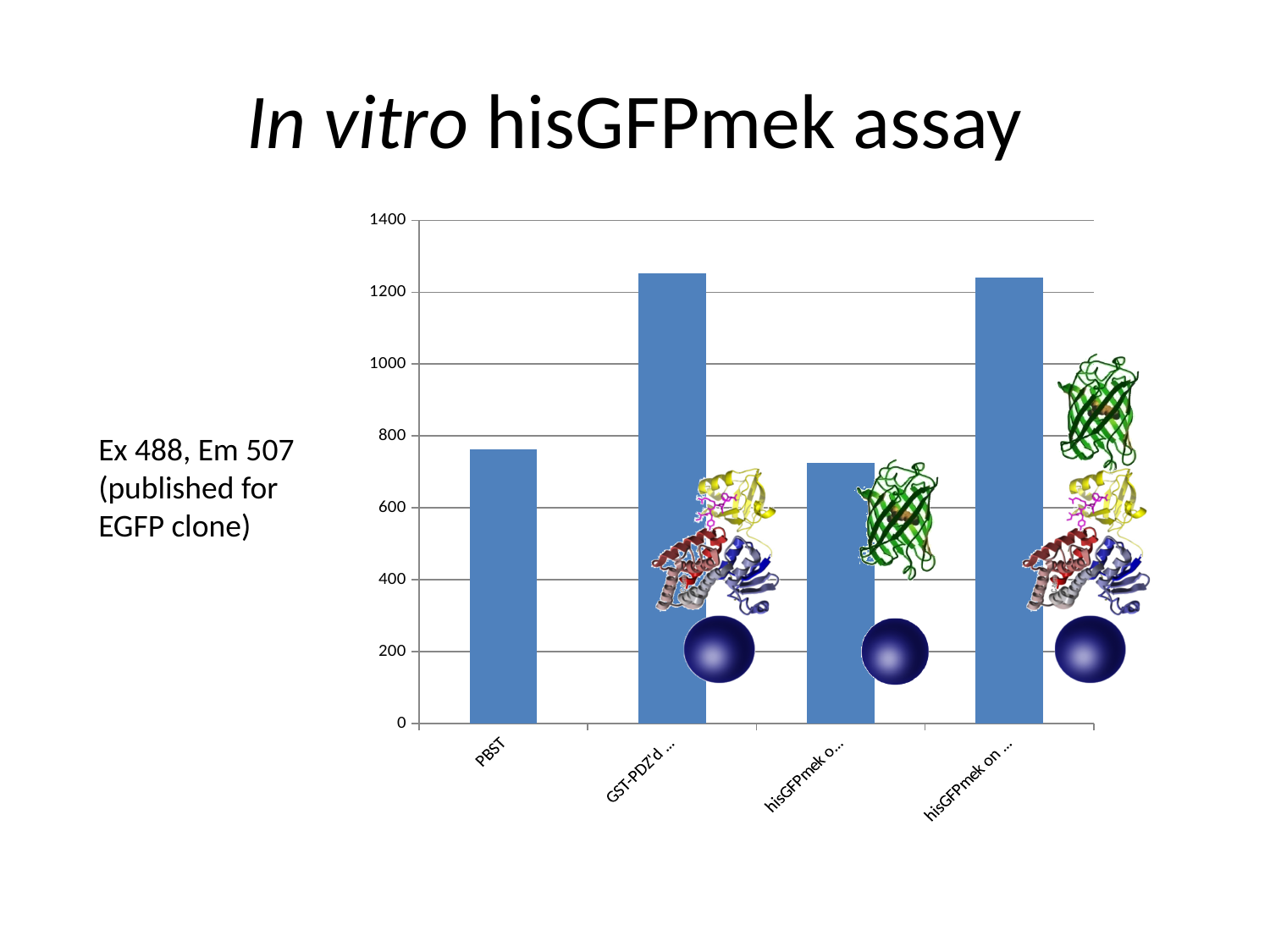
Is the value of the second bar from the left (GST-PDZ'd ...) greater or less than 1200? greater Which is larger, the value of the third bar (hisGFPmek o...) or the rightmost bar (hisGFPmek on ...)? hisGFPmek on ... What is the highest value shown on the y axis? 1400 Is the value for PBST greater or less than 800? less Is the value of the third bar from the left (hisGFPmek o...) greater or less than 800? less How many bars (categories) does the chart show? 4 What kind of chart is shown on the slide? bar chart What is the label of the leftmost category on the x axis? PBST Which is larger, the value for PBST or the value of the second bar from the left (GST-PDZ'd ...)? GST-PDZ'd ...